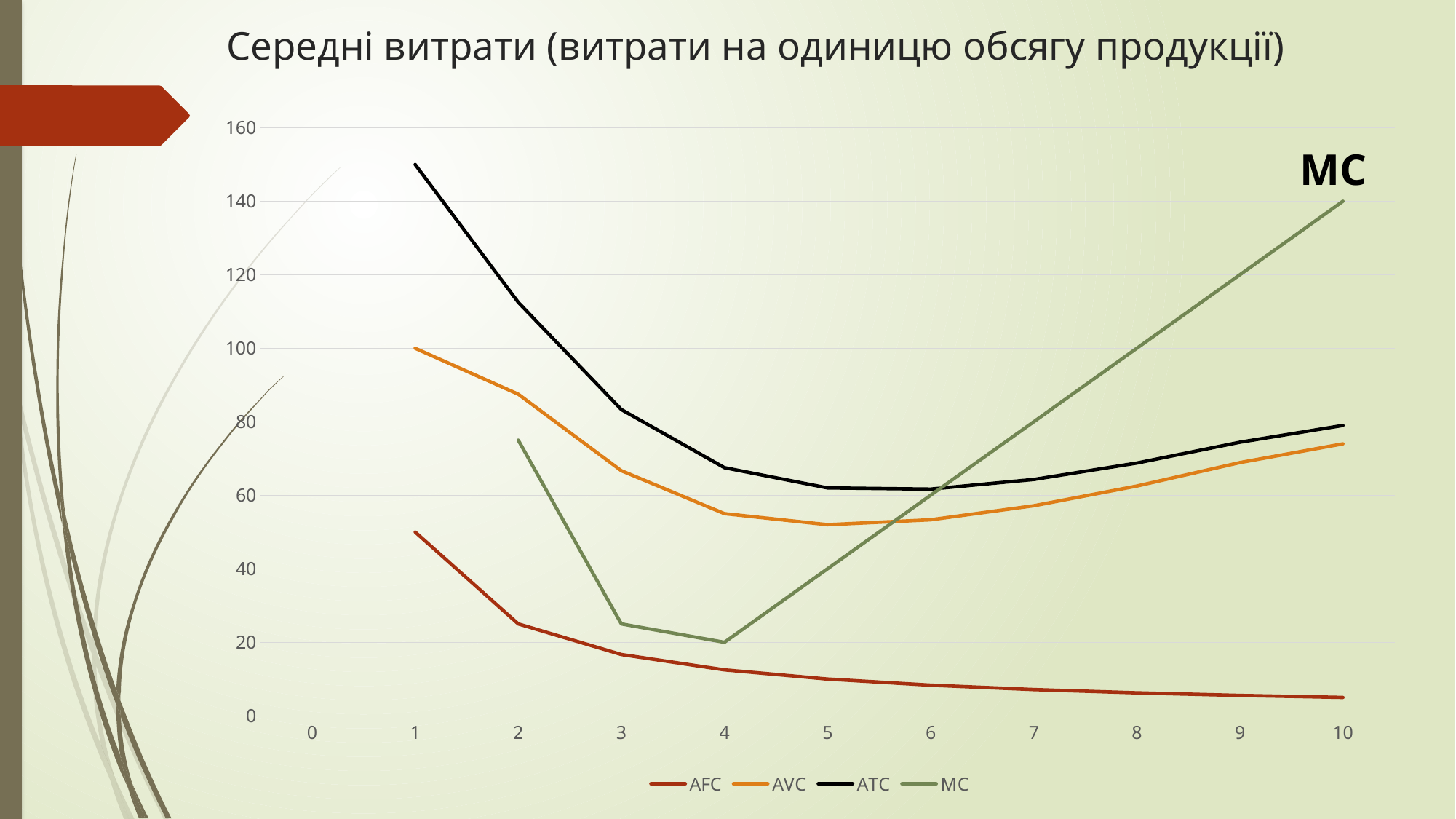
Is the value of MC at x = 2 greater or less than 80? less Is the value of AFC at x = 10 greater or less than 20? less What kind of chart is shown on the slide? line chart Does the AFC line rise or fall as x increases from 1 to 10? fall What is the value of MC at x = 4? 20 Which series has the highest value at x = 10? MC What is the title of the chart? Середні витрати (витрати на одиницю обсягу продукції) What is the value of AVC at x = 1? 100 Is the value of ATC at x = 1 greater or less than 140? greater What is the value of MC at x = 10? 140 How many series does the legend list? 4 Which series has the lowest value at x = 10? AFC